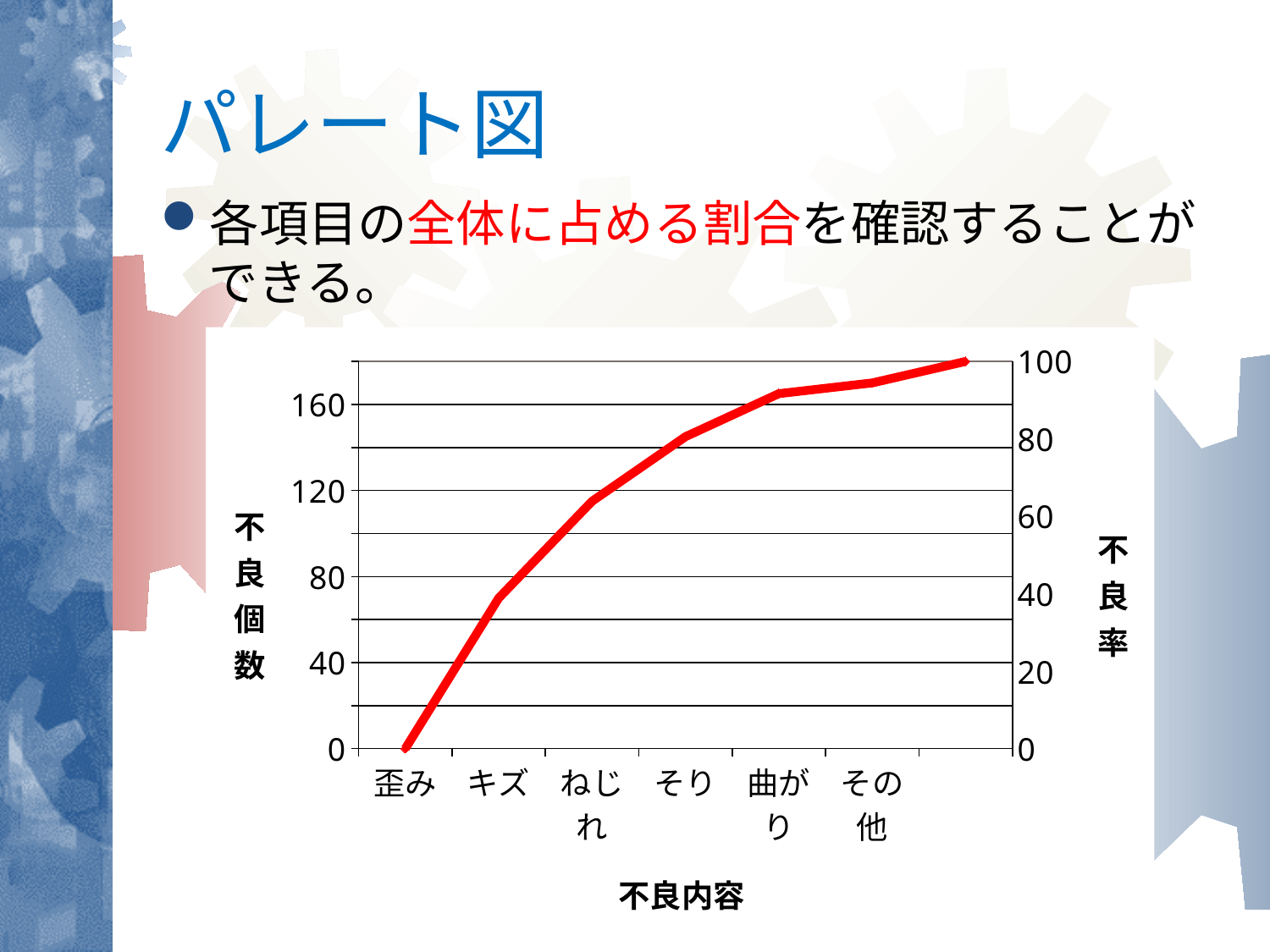
On the right-hand 不良率 axis, is the value for 曲がり greater or less than 80? greater What is the title of the right-hand vertical axis of the chart? 不良率 Does the red line rise or fall from left to right along the x axis? rise Which labelled category has the lowest value on the red line? 歪み On the right-hand 不良率 axis, is the value for そり greater or less than 60? greater How many categories are labelled on the x axis of the chart? 6 What kind of chart is shown on the slide? line chart On the right-hand 不良率 axis, is the value for ねじれ greater or less than 40? greater Which has the larger value on the red line, キズ or 曲がり? 曲がり What is the title of the x axis of the chart? 不良内容 What is the value of the red line at 歪み on the right-hand 不良率 axis? 0